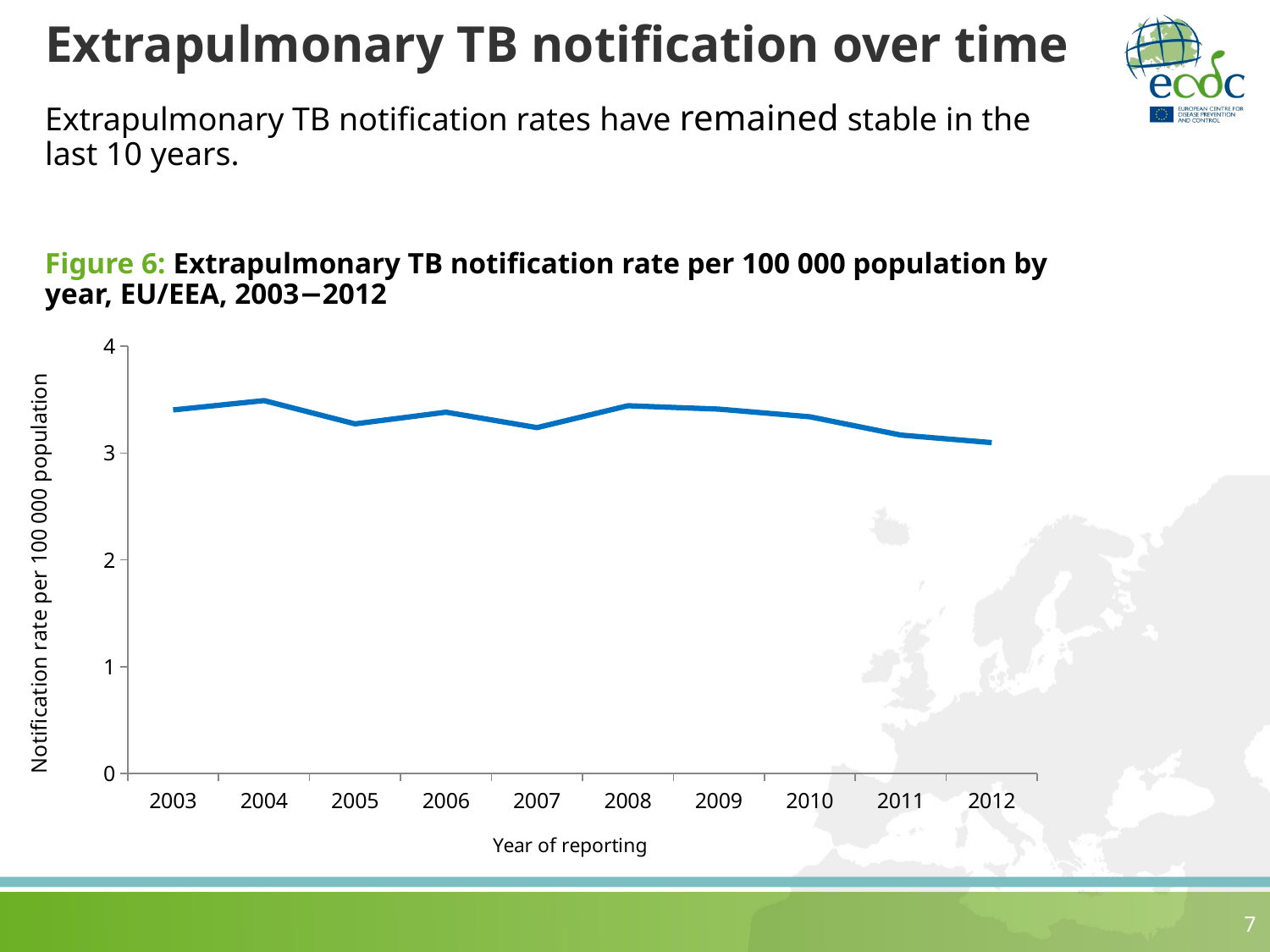
How many years are plotted on the x axis of the chart? 10 Which year has a higher notification rate, 2004 or 2012? 2004 What is the label of the x axis of the chart? Year of reporting Is the notification rate for 2008 greater or less than 3? greater Which year has the lowest extrapulmonary TB notification rate? 2012 What is the label of the y axis of the chart? Notification rate per 100 000 population Which year has a higher notification rate, 2004 or 2005? 2004 Is the notification rate for 2012 greater or less than 3? greater What kind of chart is shown on the slide? line chart Is the notification rate for 2004 greater or less than 4? less Does the notification rate rise or fall between 2010 and 2012? fall